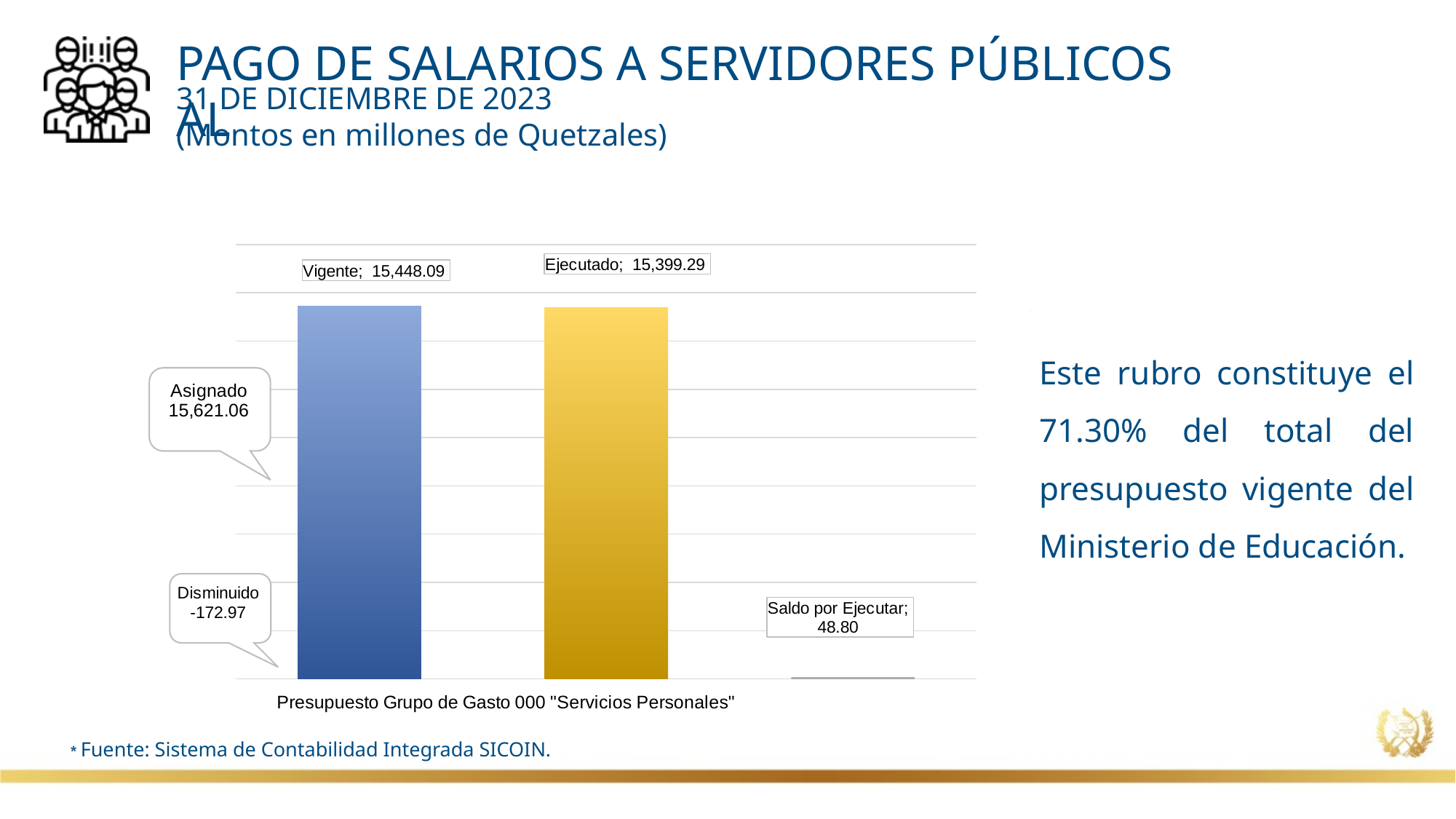
Which is larger, the Vigente value or the Ejecutado value? Vigente What value does the Asignado callout show? 15,621.06 What value does the Disminuido callout show? -172.97 What is the value labelled Saldo por Ejecutar? 48.80 What is the difference between the Vigente and Ejecutado values? 48.80 Which series has the lowest value in the chart? Saldo por Ejecutar What is the value of the Ejecutado bar? 15,399.29 What is the category label shown below the bars? Presupuesto Grupo de Gasto 000 "Servicios Personales" What is the value of the Vigente bar? 15,448.09 How many bars are plotted in the chart? 3 Which series has the highest value in the chart? Vigente What type of chart is shown on the slide? Bar chart